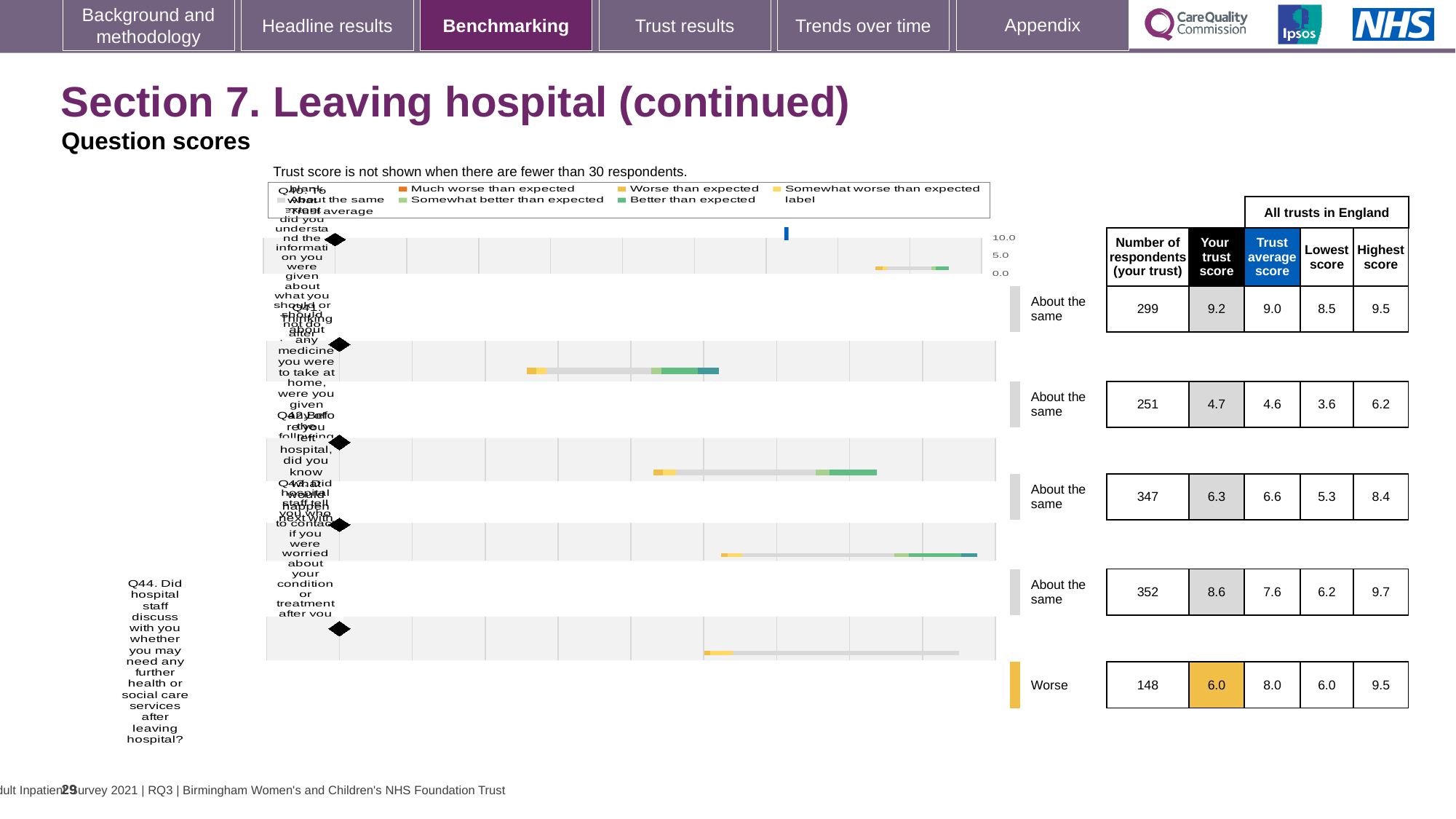
Which row has the lowest number of respondents? Q44 (148) What benchmark category is shown for Q44 (the last row)? Worse How many question rows are plotted in the benchmarking chart? 5 What is the number of respondents for Q44 (the last row)? 148 What kind of chart is used to show the question scores on this slide? bar chart What is the highest score across all trusts in England for the first row? 9.5 In the first row, which is larger: the trust's score or the trust average score? the trust's score (9.2) What is the trust's score for Q44 (the last row)? 6.0 For Q44 (the last row), what is the difference between the trust average score and the trust's own score? 2.0 Which row has the highest 'Your trust score'? the first row (9.2) What is the trust average score for Q44 (the last row)? 8.0 How many of the question rows are rated 'About the same'? 4